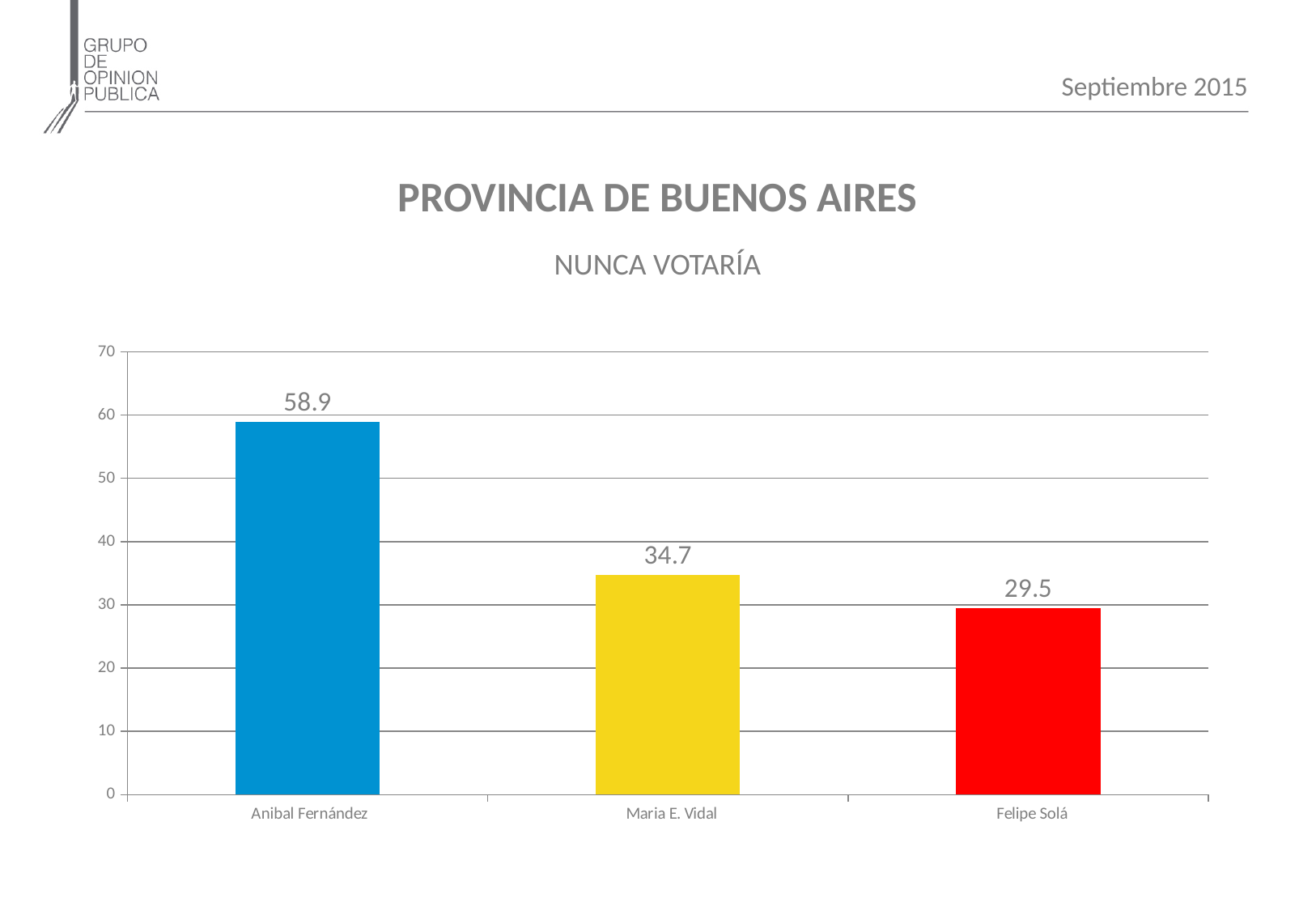
What is the value for Maria E. Vidal? 34.7 Is the value for Anibal Fernández greater or less than 50? greater What kind of chart is shown on the slide? bar chart What is the value for Anibal Fernández? 58.9 Which candidate has the lowest value? Felipe Solá What is the difference between the values for Anibal Fernández and Maria E. Vidal? 24.2 Which candidate has the highest value? Anibal Fernández Which is larger, the value for Maria E. Vidal or the value for Felipe Solá? Maria E. Vidal What is the difference between the values for Maria E. Vidal and Felipe Solá? 5.2 What is the subtitle of the chart below 'PROVINCIA DE BUENOS AIRES'? NUNCA VOTARÍA How many candidates are shown in the chart? 3 What is the value for Felipe Solá? 29.5